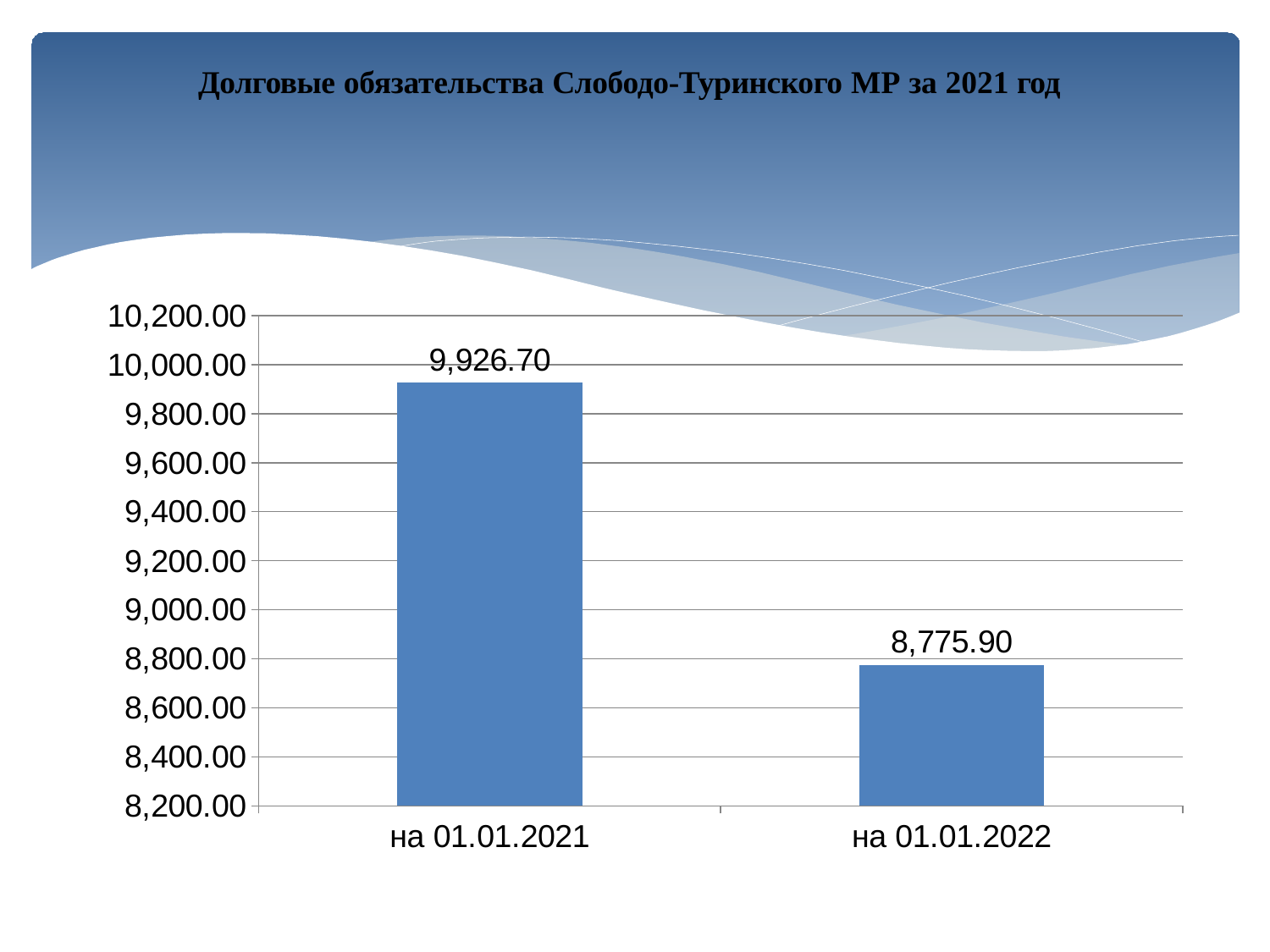
Which category has the lowest value? на 01.01.2022 What is the title of the slide? Долговые обязательства Слободо-Туринского МР за 2021 год Do the values rise or fall from на 01.01.2021 to на 01.01.2022? fall What is the value for на 01.01.2022? 8,775.90 How many categories are shown on the x axis? 2 Which is larger, the value for на 01.01.2021 or the value for на 01.01.2022? на 01.01.2021 Is the value for на 01.01.2022 greater or less than 9,000.00? less What is the value for на 01.01.2021? 9,926.70 Which category has the highest value? на 01.01.2021 What is the difference between the values for на 01.01.2021 and на 01.01.2022? 1,150.80 Is the value for на 01.01.2021 greater or less than 9,800.00? greater What kind of chart is shown on the slide? bar chart